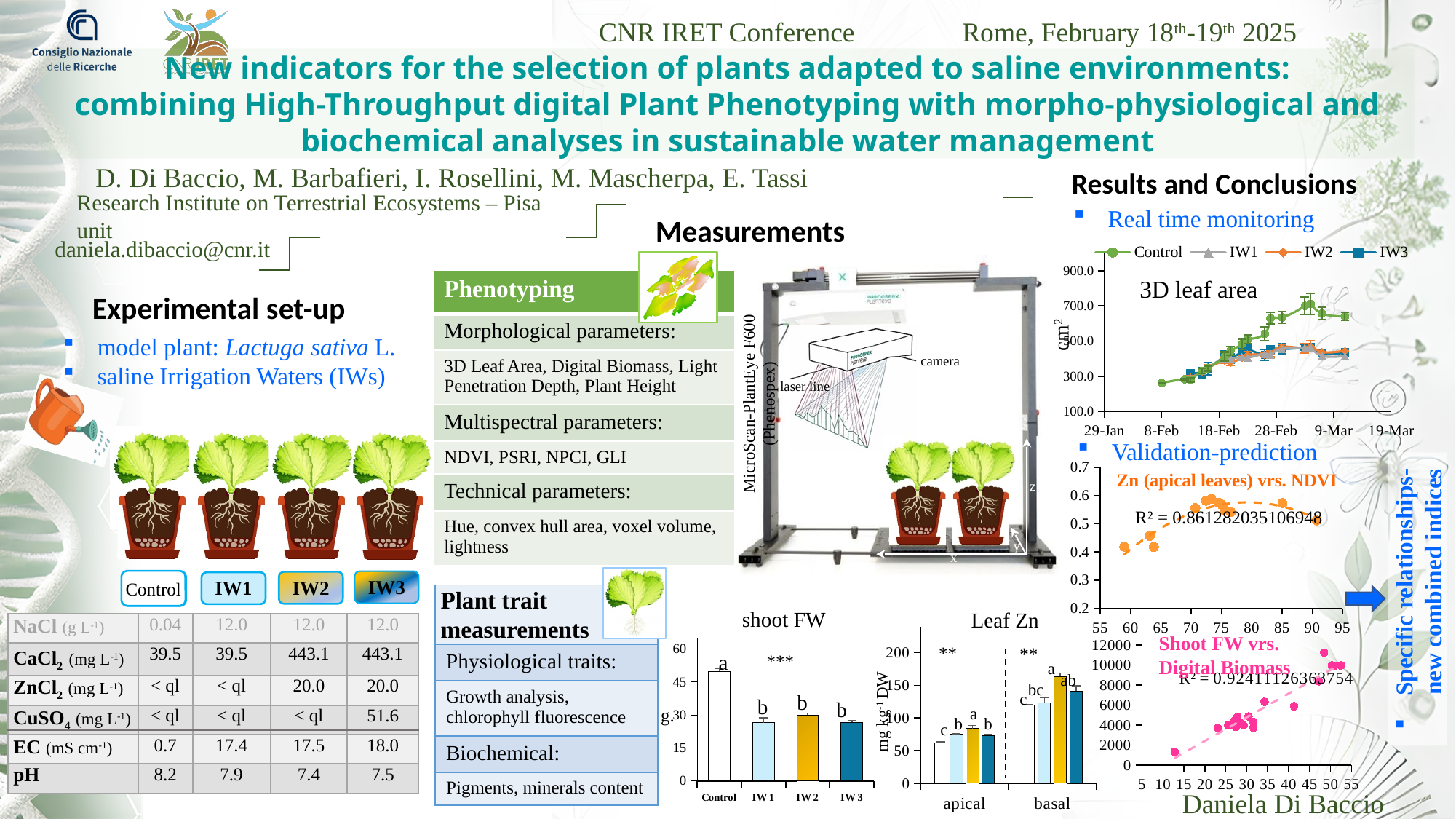
What kind of chart is the shoot FW chart? bar chart In the 3D leaf area chart, is the Control value around 9-Mar greater or less than 500.0? greater In the 3D leaf area chart, how many series does the legend list? 4 In the Leaf Zn chart, which is larger for IW2: the apical value or the basal value? basal In the 3D leaf area chart, which series are listed in the legend? Control, IW1, IW2, IW3 In the shoot FW chart, is the value for Control greater or less than 45? greater In the shoot FW chart, which treatment has the highest shoot fresh weight? Control In the shoot FW chart, how many treatment categories are shown? 4 What R² value is shown on the Zn (apical leaves) vrs. NDVI chart? R² = 0.861282035106948 In the Leaf Zn chart, is the basal value for IW2 greater or less than 150? greater In the 3D leaf area chart, does the Control series rise or fall over time along the x axis? rise